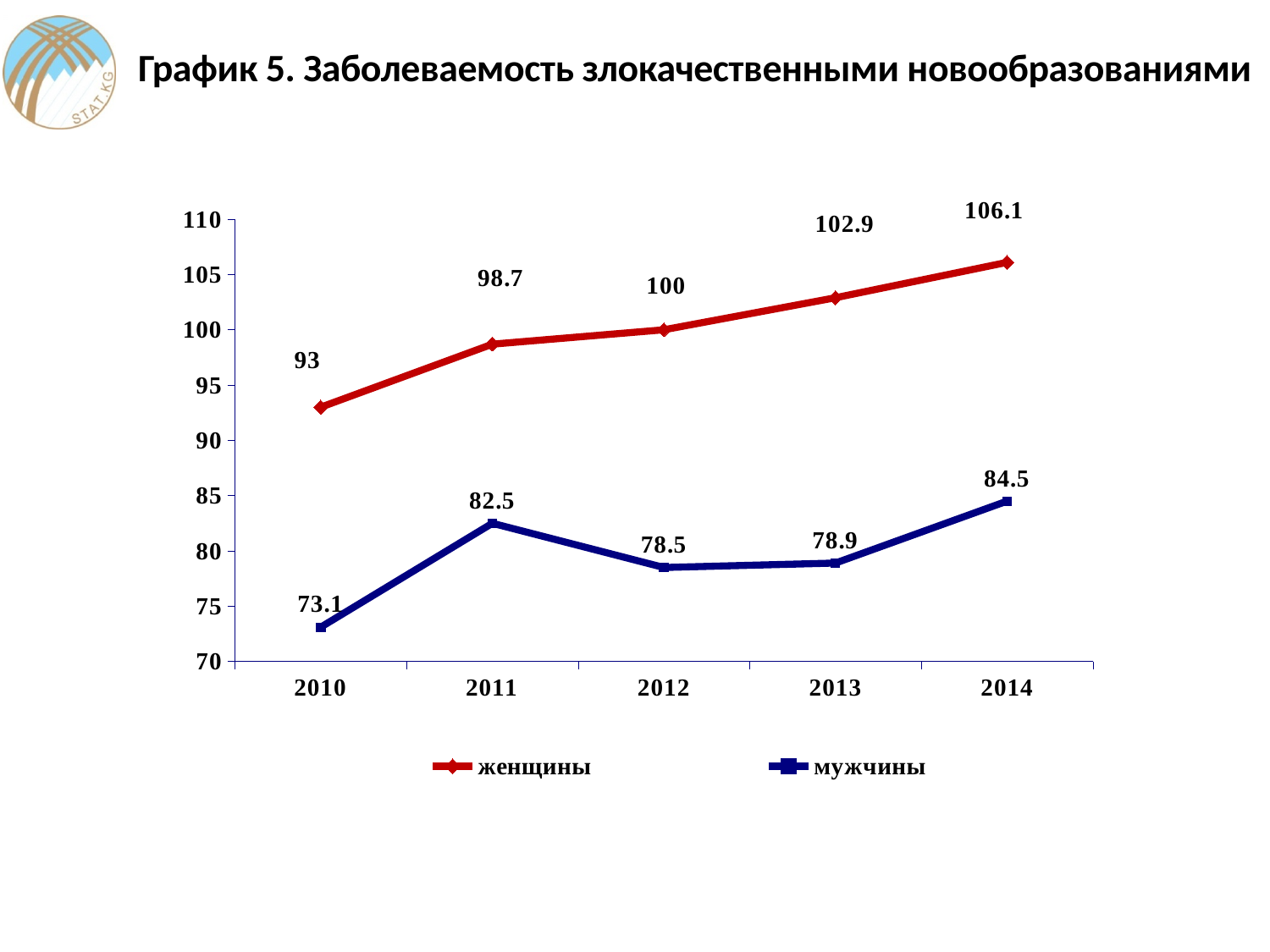
Which is larger: the мужчины value in 2011 or in 2013? 2011 In which year is the value for женщины highest? 2014 What is the value for мужчины in 2014? 84.5 In which year is the value for мужчины lowest? 2010 What is the value for мужчины in 2010? 73.1 Which colour is used for the мужчины series? Blue How many years are shown on the x axis? 5 How many series does the legend list? 2 What is the value for женщины in 2012? 100 What type of chart is shown on the slide? Line chart What is the difference between the женщины and мужчины values in 2014? 21.6 Does the женщины series rise or fall from 2010 to 2014? Rises